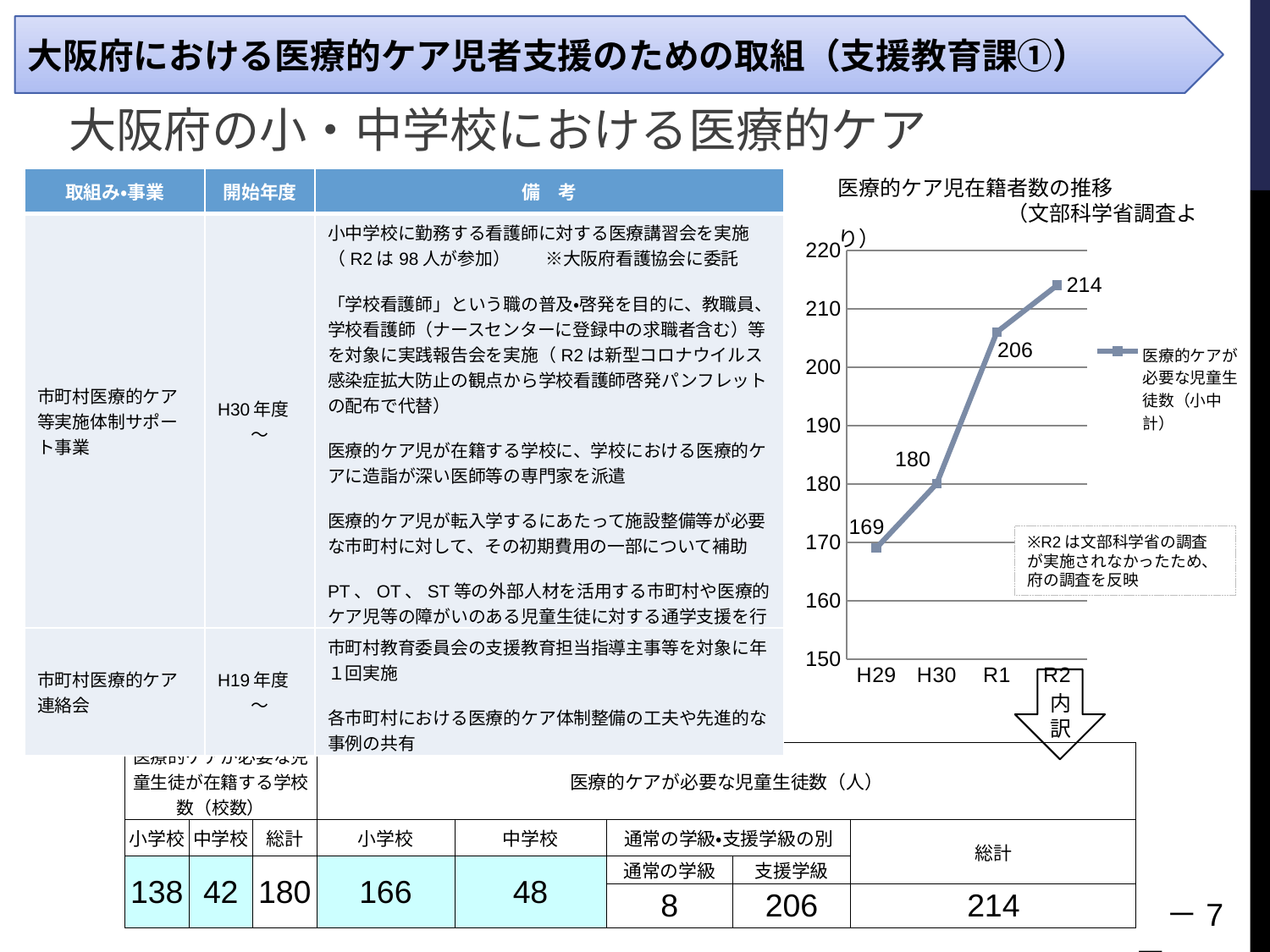
What is the value for H30 in the chart 医療的ケア児在籍者数の推移? 180 Which year has the highest value in the chart 医療的ケア児在籍者数の推移? R2 What is the value for R1 in the chart 医療的ケア児在籍者数の推移? 206 Do the values in the chart rise or fall from H29 to R2? rise Which is larger in the chart, the value for H30 or the value for R1? R1 What is the difference between the values for R2 and H29 in the chart? 45 What type of chart is shown on the slide? line chart What is the difference between the values for R1 and H30 in the chart? 26 Which year has the lowest value in the chart 医療的ケア児在籍者数の推移? H29 How many data points are plotted in the chart 医療的ケア児在籍者数の推移? 4 What is the value for R2 in the chart 医療的ケア児在籍者数の推移? 214 What is the value for H29 in the chart 医療的ケア児在籍者数の推移? 169